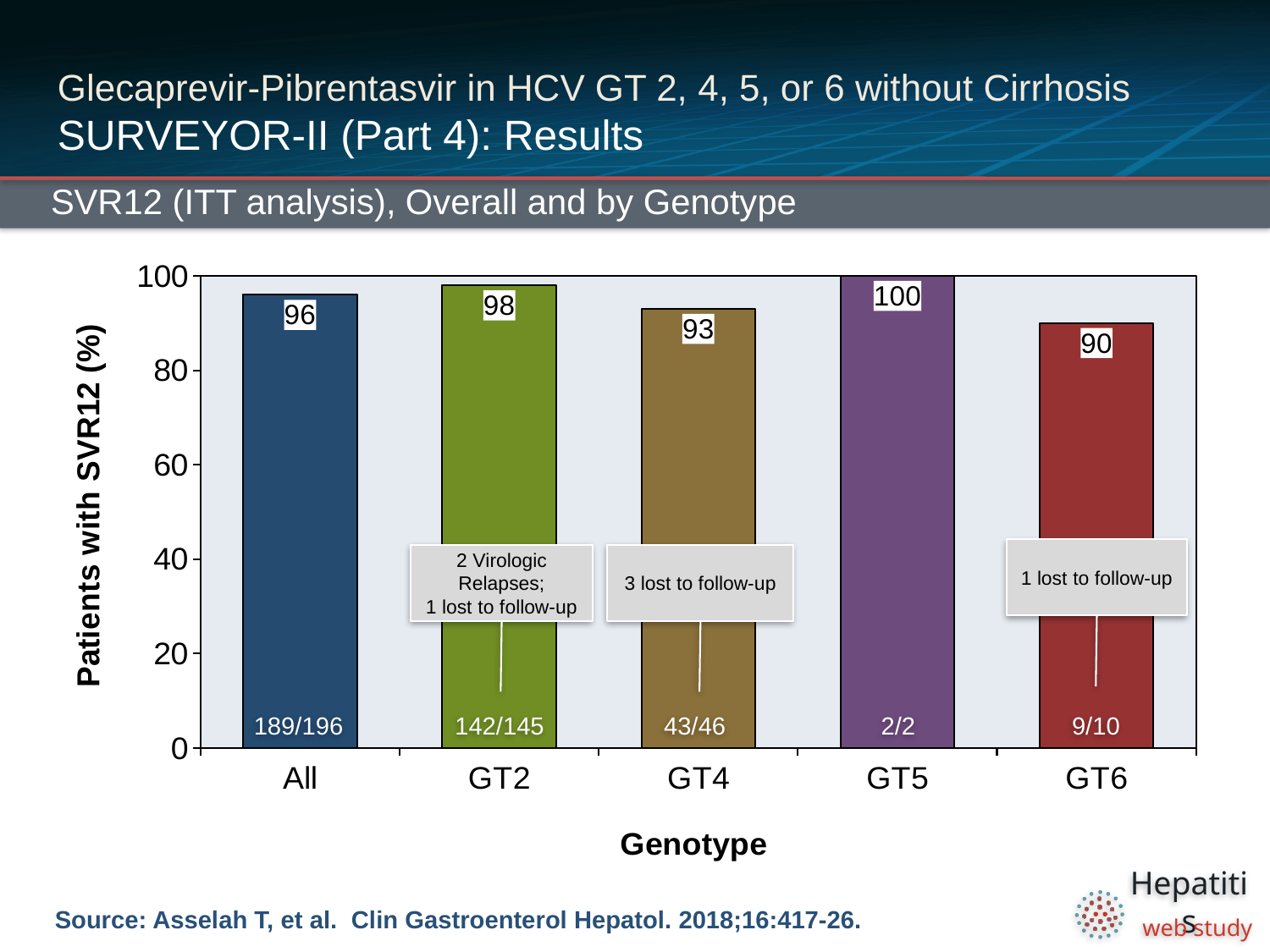
What is the SVR12 rate for GT6? 90 Which genotype has the lowest SVR12 rate? GT6 How many categories are shown on the x axis? 5 What is the SVR12 rate for GT2? 98 Which genotype has the highest SVR12 rate? GT5 What is the SVR12 rate for the All group? 96 Which has a higher SVR12 rate, GT4 or GT6? GT4 Is the SVR12 rate for GT6 greater or less than 80? greater What kind of chart is shown on the slide? Bar chart What is the difference in SVR12 rate between GT2 and GT4? 5 What is the label of the y axis? Patients with SVR12 (%) How many patients achieved SVR12 in the GT4 group, as shown at the base of the bar? 43/46